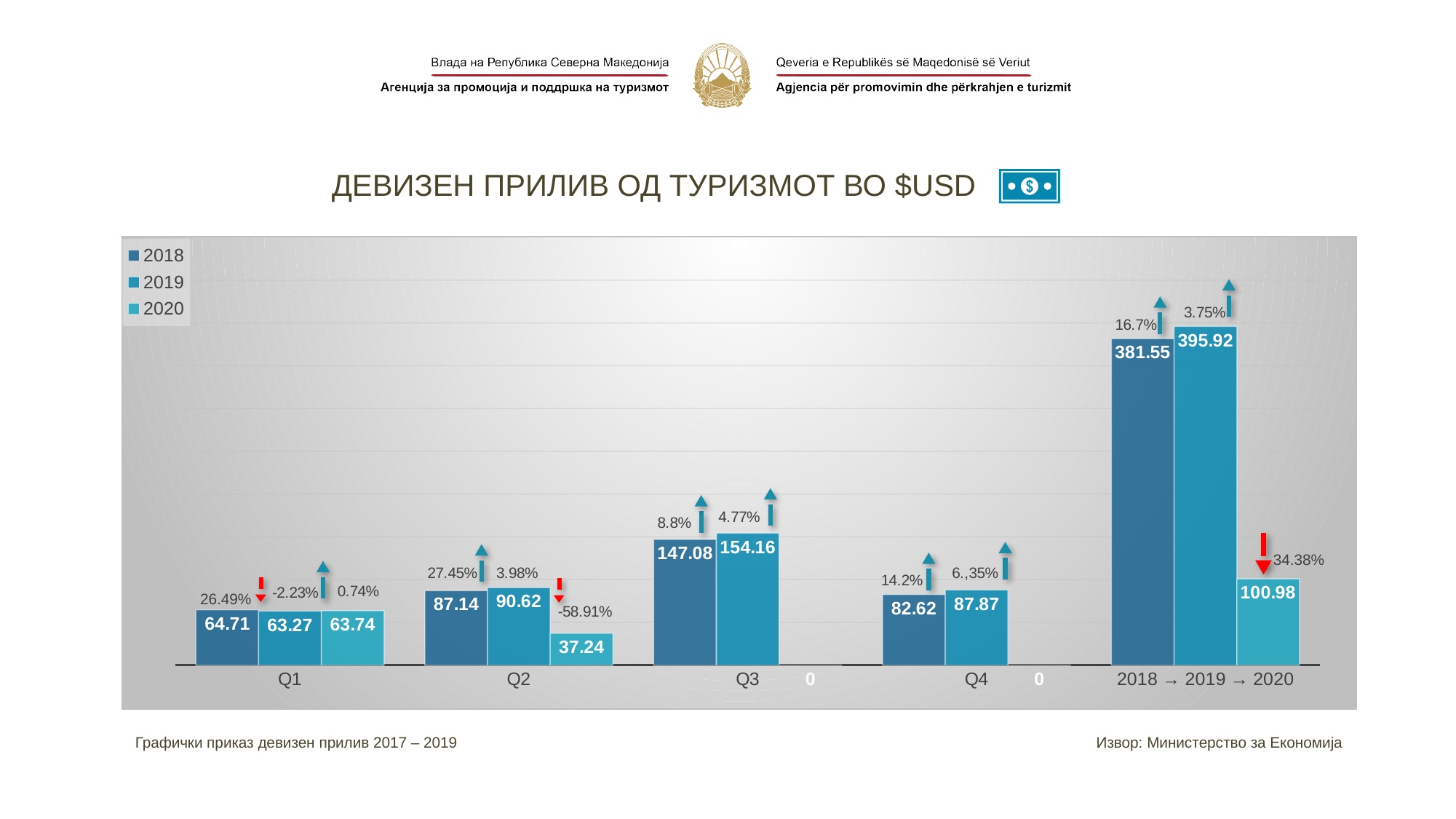
What is the value for 2020 in Q1? 63.74 Which is larger in Q4, the 2018 value or the 2019 value? 2019 Which quarter has the lowest value for the 2019 series? Q1 What is the value for 2020 in Q2? 37.24 What is the difference between the 2019 and 2018 annual values in the 2018 → 2019 → 2020 group? 14.37 Which quarter has the highest value for the 2018 series? Q3 How many series does the legend list? 3 What is the difference between the 2019 and 2020 values in Q2? 53.38 What is the value for 2018 in the annual group labelled 2018 → 2019 → 2020? 381.55 What kind of chart is shown on the slide? bar chart What percentage change label is shown above the 2020 bar in Q2? -58.91% What is the value for 2019 in Q3? 154.16